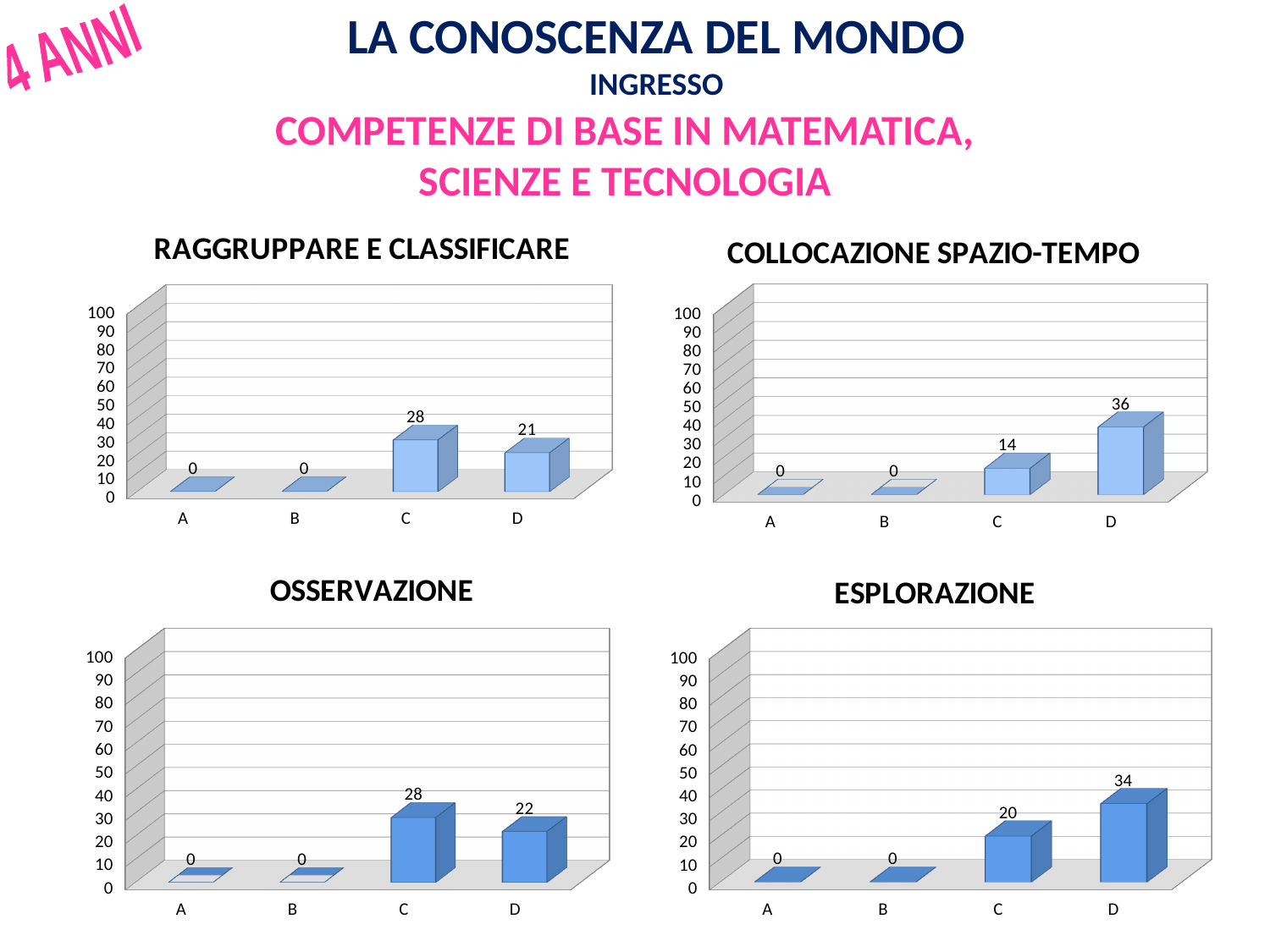
In the ESPLORAZIONE chart, is the value for D greater or less than 30? greater What kind of chart is the COLLOCAZIONE SPAZIO-TEMPO chart? bar chart In the RAGGRUPPARE E CLASSIFICARE chart, what is the value for D? 21 In the COLLOCAZIONE SPAZIO-TEMPO chart, what is the difference between the values for D and C? 22 In the ESPLORAZIONE chart, what is the difference between the values for D and C? 14 In the OSSERVAZIONE chart, which is larger, the value for C or the value for D? C In the ESPLORAZIONE chart, what is the value for C? 20 How many categories are shown in the RAGGRUPPARE E CLASSIFICARE chart? 4 In the COLLOCAZIONE SPAZIO-TEMPO chart, what is the value for B? 0 In the OSSERVAZIONE chart, what is the value for D? 22 In the COLLOCAZIONE SPAZIO-TEMPO chart, which category has the highest value? D In the RAGGRUPPARE E CLASSIFICARE chart, what is the value for C? 28